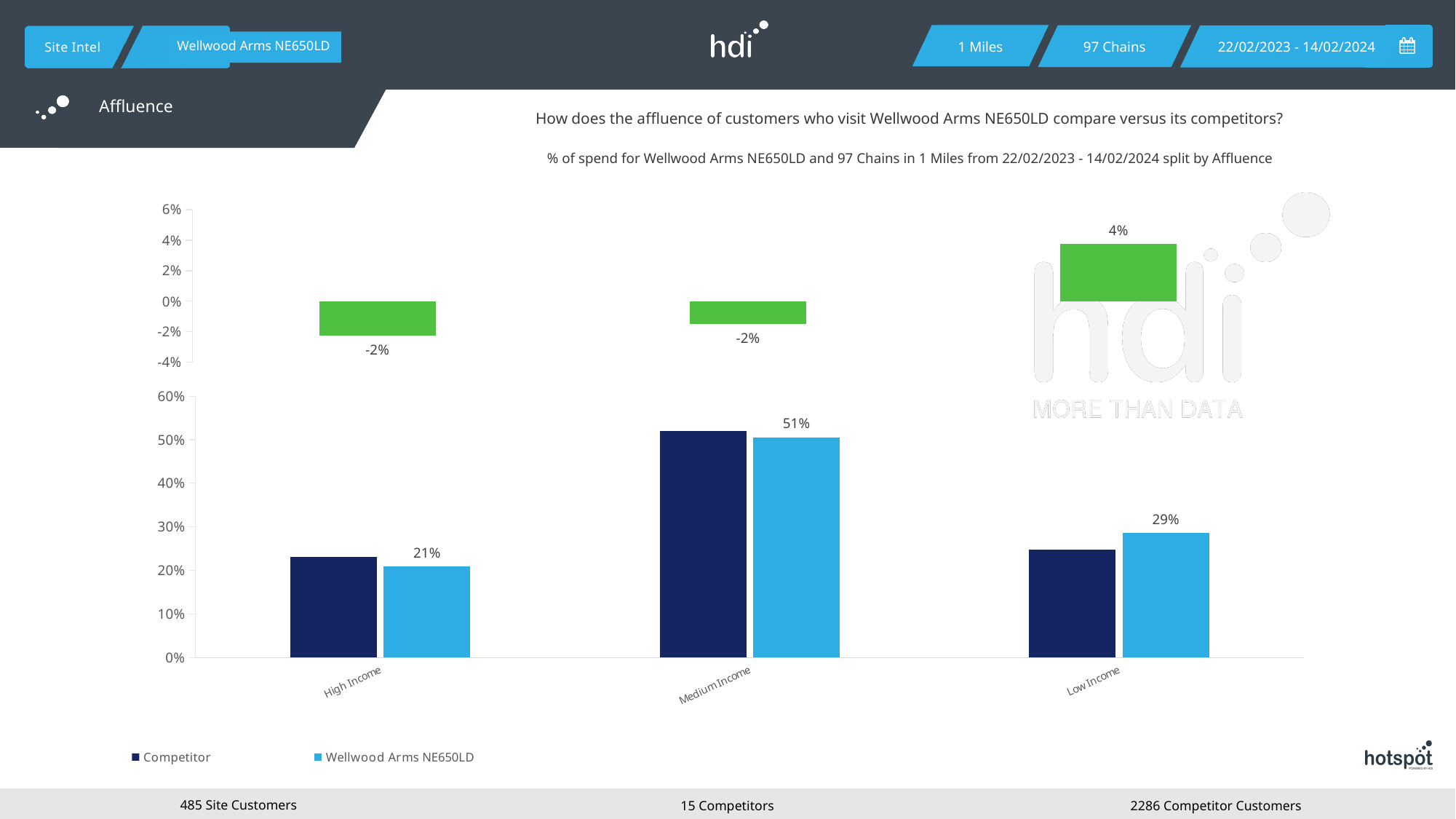
What type of chart is the bottom chart? Bar chart In the bottom chart, what is the difference between the Wellwood Arms NE650LD values for Medium Income and Low Income? 22% In the bottom chart, what is the value for Wellwood Arms NE650LD in the Medium Income category? 51% In the top chart with green bars, what is the value for High Income? -2% In the bottom chart, is the Competitor value for Low Income greater or less than 30%? less In the bottom chart, what is the value for Wellwood Arms NE650LD in the High Income category? 21% In the bottom chart, which category has the highest value for Wellwood Arms NE650LD? Medium Income In the bottom chart, for Low Income, which series has the larger value: Competitor or Wellwood Arms NE650LD? Wellwood Arms NE650LD In the bottom chart, which category has the lowest value for Wellwood Arms NE650LD? High Income In the top chart with green bars, what is the value for Low Income? 4% How many series does the legend of the bottom chart list? 2 In the bottom chart, what is the value for Wellwood Arms NE650LD in the Low Income category? 29%